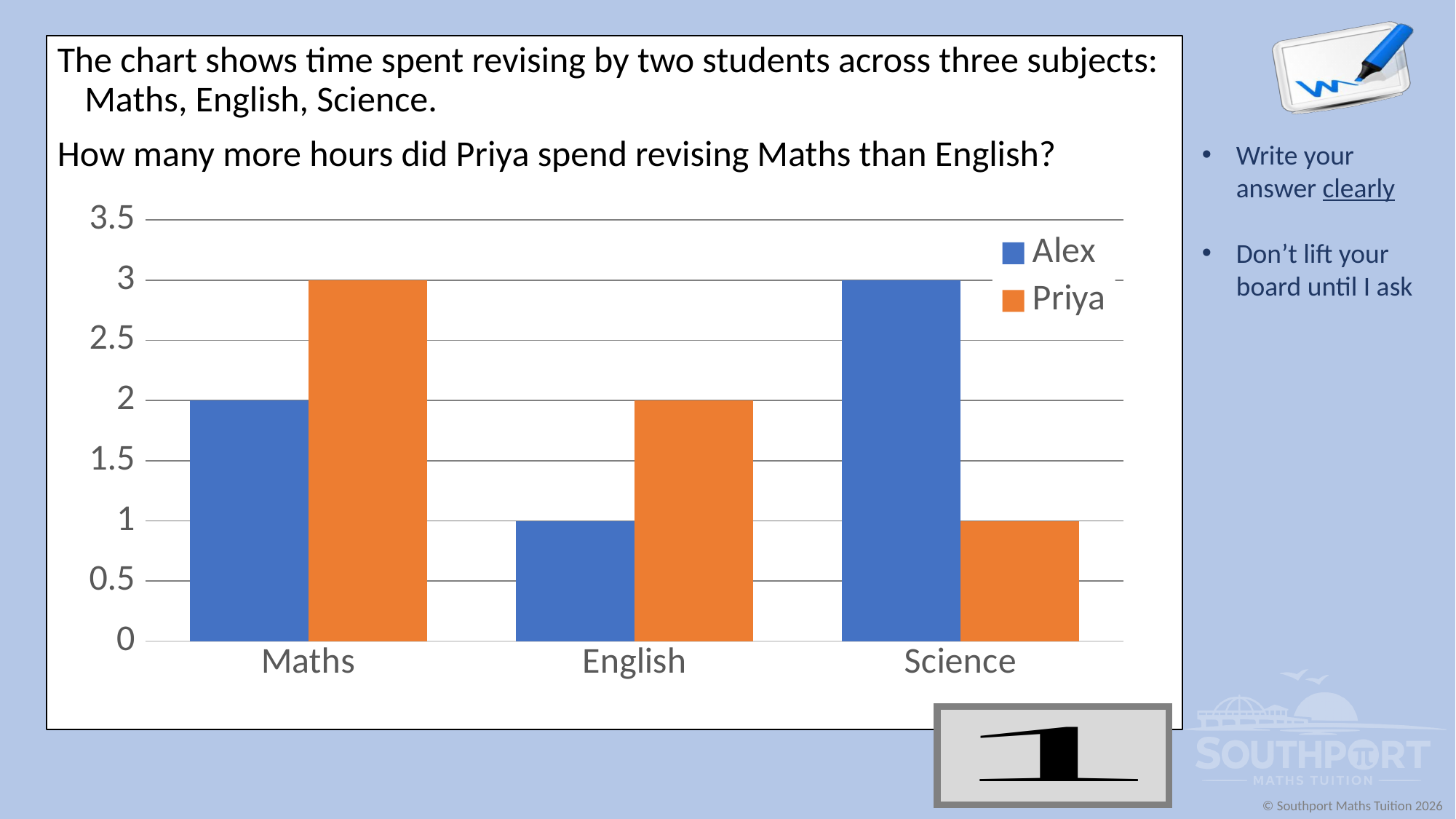
How many hours did Alex spend revising English? 1 How many series does the legend list? 2 How many hours did Priya spend revising Maths? 3 How many hours did Alex spend revising Science? 3 How many more hours did Priya spend revising Maths than English? 1 In which subject did Alex spend the most time revising? Science Who spent more time revising English, Alex or Priya? Priya How many subjects are shown on the x axis? 3 What is the difference between Alex's and Priya's revision hours for Science? 2 In which subject did Priya spend the least time revising? Science What kind of chart is shown on the slide? Bar chart How many hours did Priya spend revising Science? 1